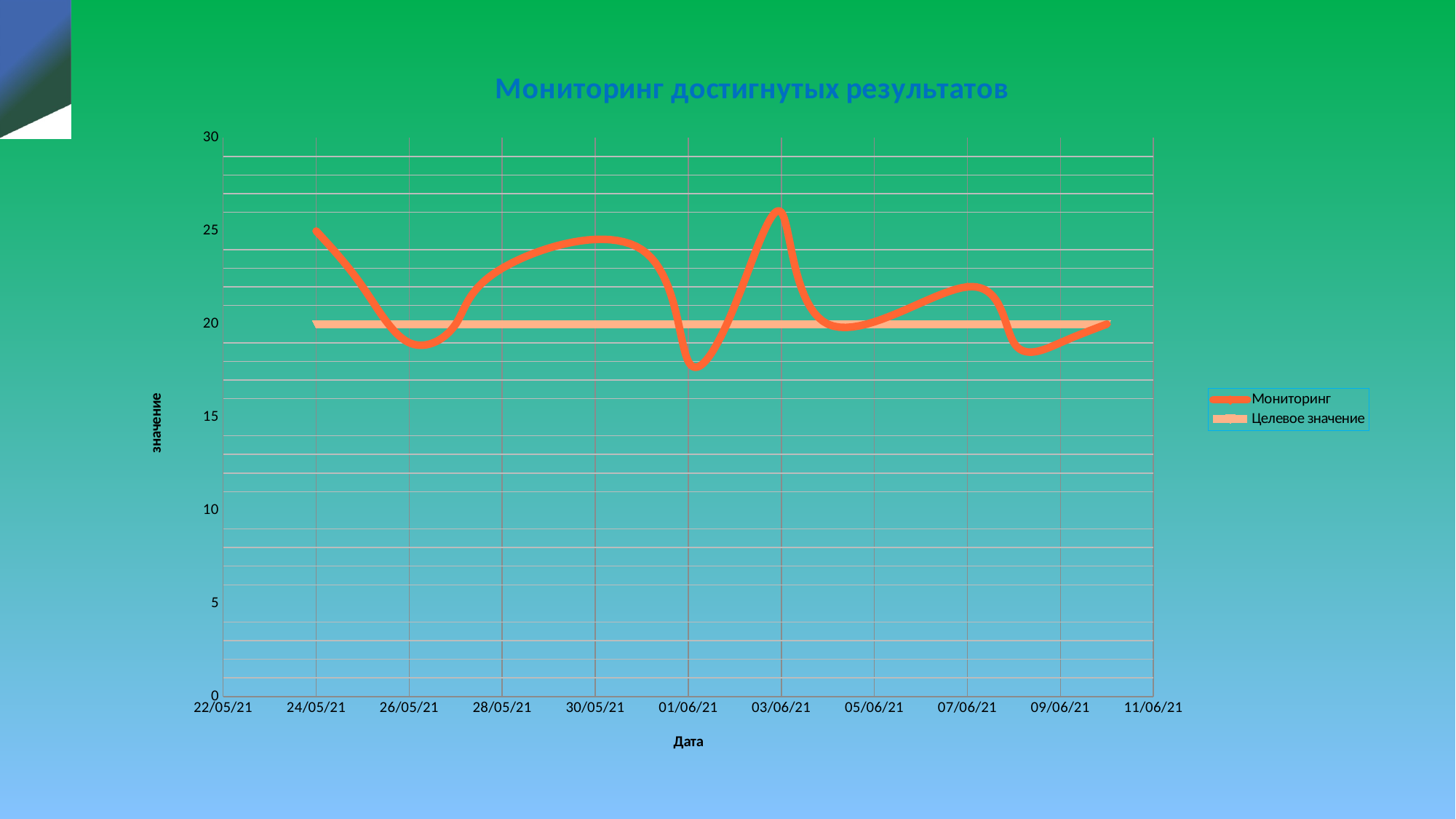
What are the two series named in the legend? Мониторинг, Целевое значение Which is larger, the Мониторинг value on 24/05/21 or on 26/05/21? 24/05/21 Is the Мониторинг value on 03/06/21 greater or less than 25? greater What is the value of the Целевое значение line? 20 On which date does the Мониторинг line reach its lowest value? 01/06/21 Is the Мониторинг value on 09/06/21 greater or less than 20? less On which date does the Мониторинг line reach its highest value? 03/06/21 How many series does the legend list? 2 What is the title of the chart? Мониторинг достигнутых результатов What kind of chart is shown on the slide? line chart Is the Мониторинг value on 30/05/21 greater or less than 20? greater